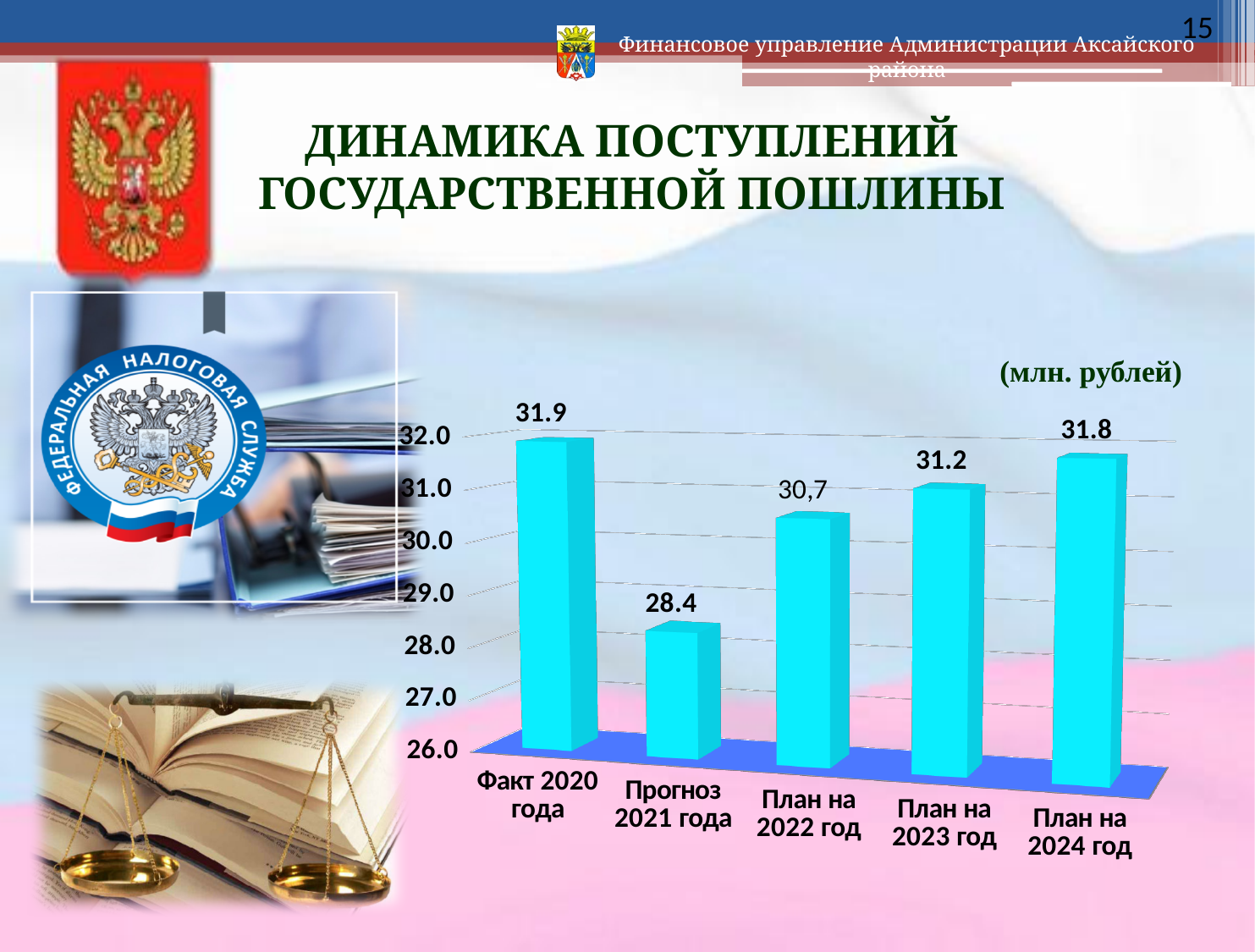
What unit of measurement is indicated for the chart values? млн. рублей What is the value for План на 2022 год? 30,7 What is the difference between the values for План на 2024 год and План на 2023 год? 0.6 What is the value for План на 2024 год? 31.8 What kind of chart is shown on the slide? Bar chart What is the value for Прогноз 2021 года? 28.4 Which category has the lowest value? Прогноз 2021 года What is the difference between the values for Факт 2020 года and Прогноз 2021 года? 3.5 Which category has the highest value? Факт 2020 года Which is larger, the value for План на 2023 год or the value for План на 2022 год? План на 2023 год What is the value for Факт 2020 года? 31.9 How many categories are shown on the chart? 5